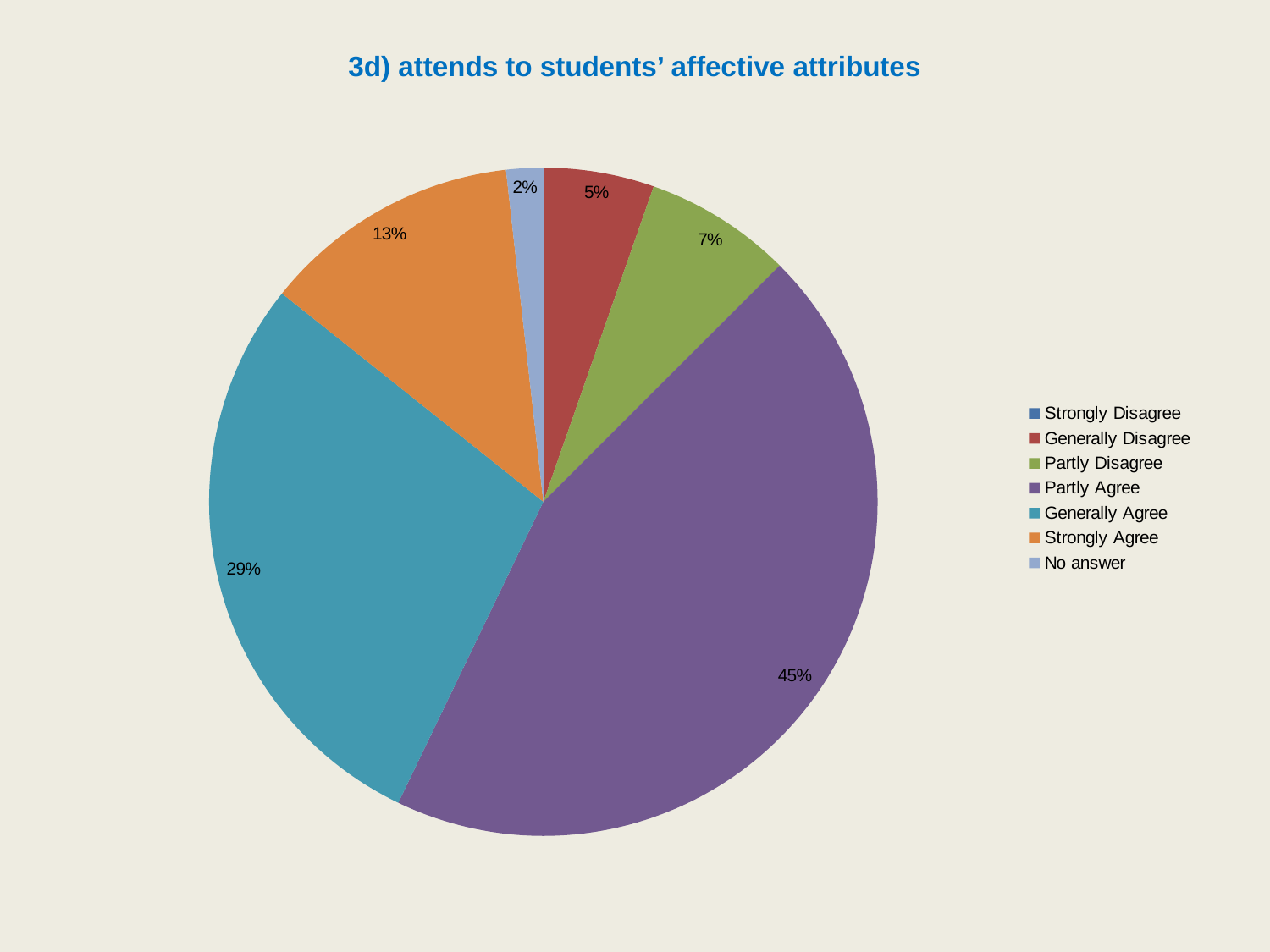
What is the title of the chart? 3d) attends to students' affective attributes How many entries does the legend list? 7 What is the difference between the Partly Agree and Generally Agree shares? 16% What percentage of the pie is Partly Disagree? 7% What kind of chart is shown on the slide? pie chart What percentage of the pie is Partly Agree? 45% What percentage of the pie is Generally Agree? 29% Which category has the largest share of the pie? Partly Agree Which of the labelled slices has the smallest share of the pie? No answer What percentage of the pie is No answer? 2% What percentage of the pie is Strongly Agree? 13% What percentage of the pie is Generally Disagree? 5%